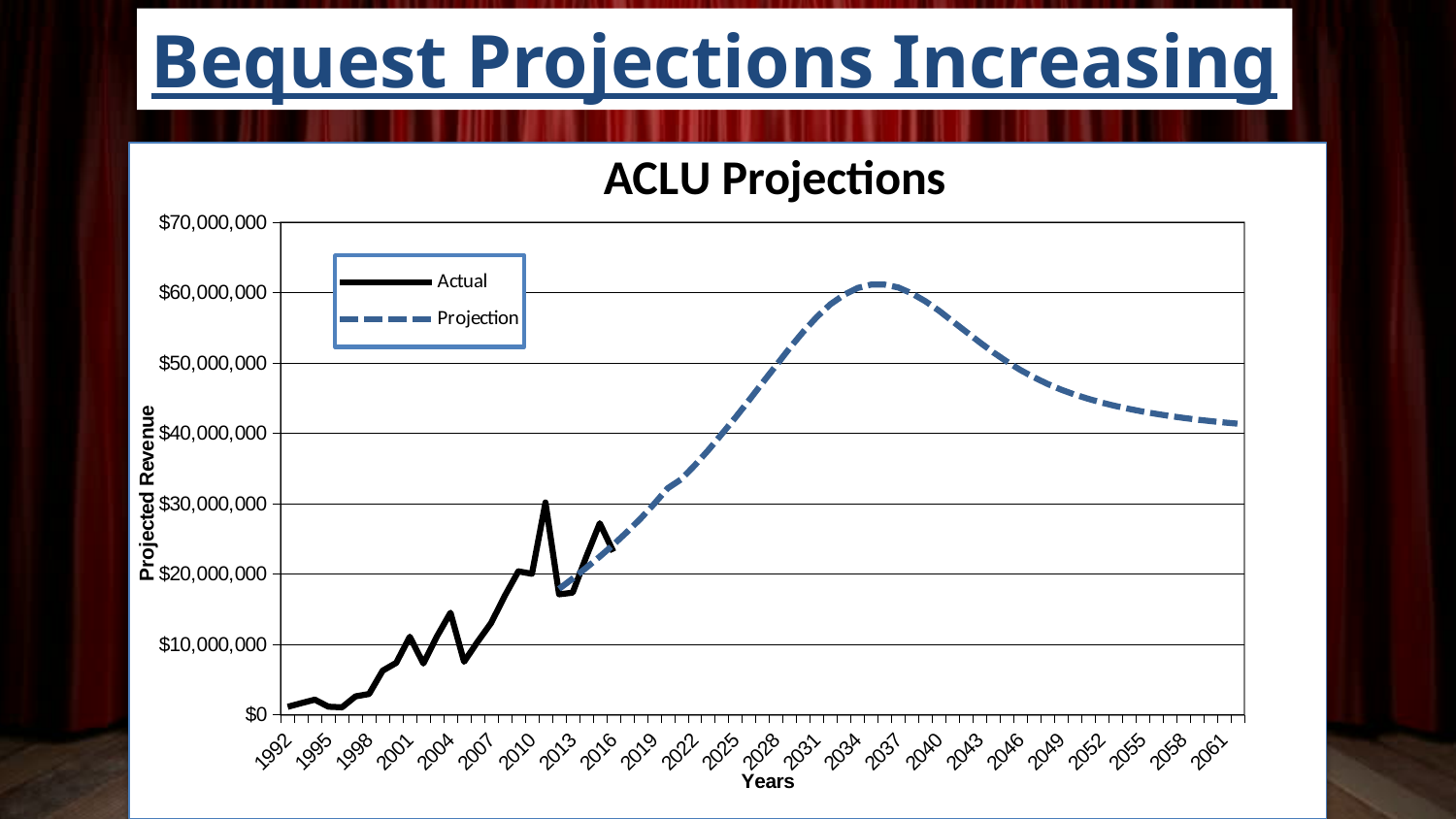
What kind of chart is shown on the slide? Line chart Is the Projection value for 2022 greater or less than $30,000,000? greater How many series does the legend of the ACLU Projections chart list? 2 Is the Actual value for 1992 greater or less than $10,000,000? less Which is larger, the Projection value for 2037 or for 2061? 2037 What is the title of the chart on the slide? ACLU Projections Is the Actual value for 2004 greater or less than $10,000,000? greater Which series in the ACLU Projections chart is drawn with a dashed line? Projection Does the Projection series rise or fall between 2037 and 2061? fall Which is larger, the Actual value for 2011 or for 2013? 2011